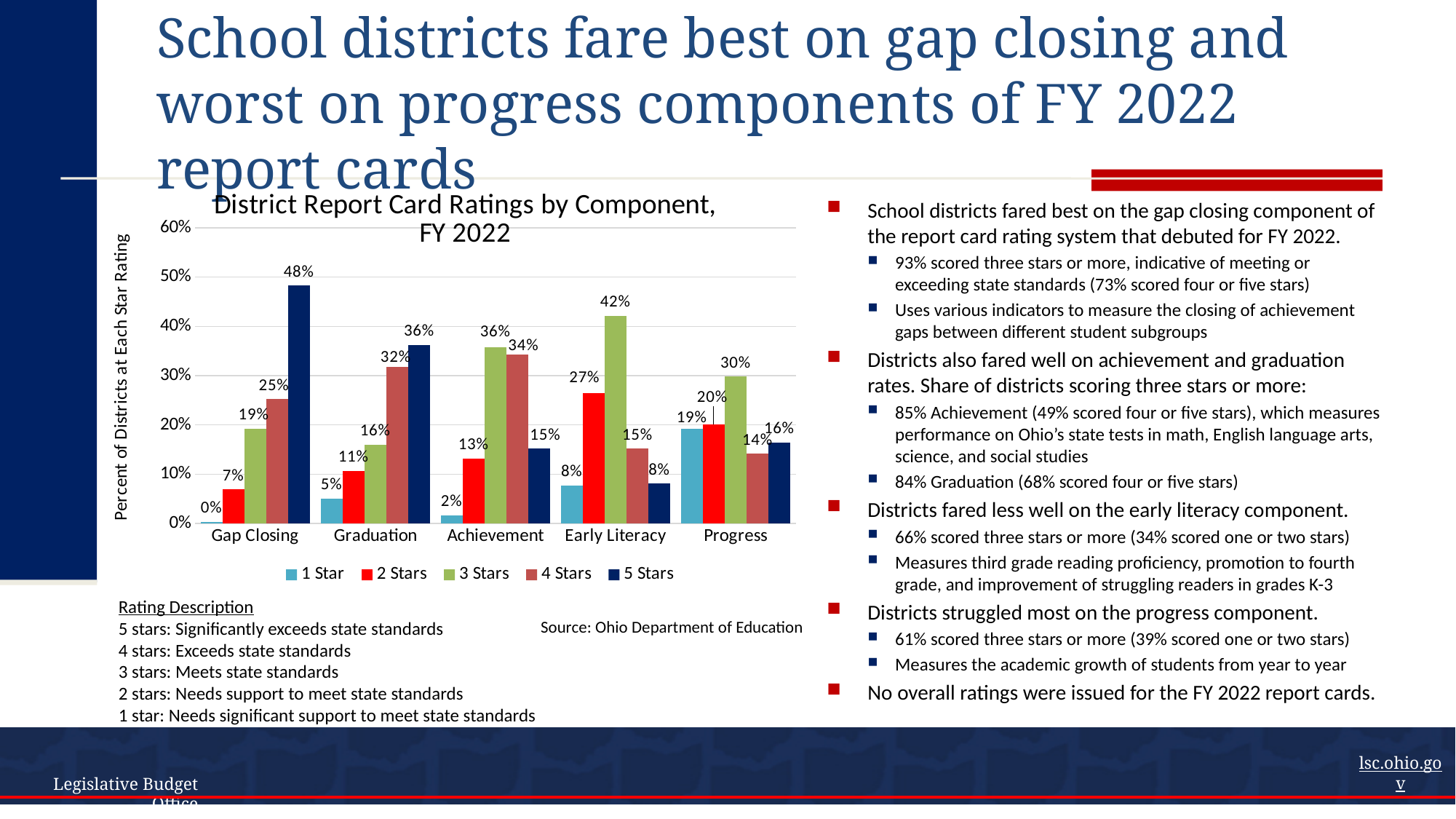
Which component has the highest share of districts with 5 Stars? Gap Closing How many series does the chart legend list? 5 Which component has the lowest share of districts with 1 Star? Gap Closing What is the title of the chart? District Report Card Ratings by Component, FY 2022 What percent of districts received 4 Stars on the Graduation component? 32% What is the difference between the 5 Stars share for Gap Closing and the 5 Stars share for Graduation? 12% Which is larger: the 3 Stars share for Achievement or the 4 Stars share for Achievement? 3 Stars share for Achievement What percent of districts received 3 Stars on the Early Literacy component? 42% What percent of districts received 1 Star on the Progress component? 19% What percent of districts received 5 Stars on the Gap Closing component? 48% How many components are shown on the x axis of the chart? 5 What type of chart is shown on the slide? Bar chart